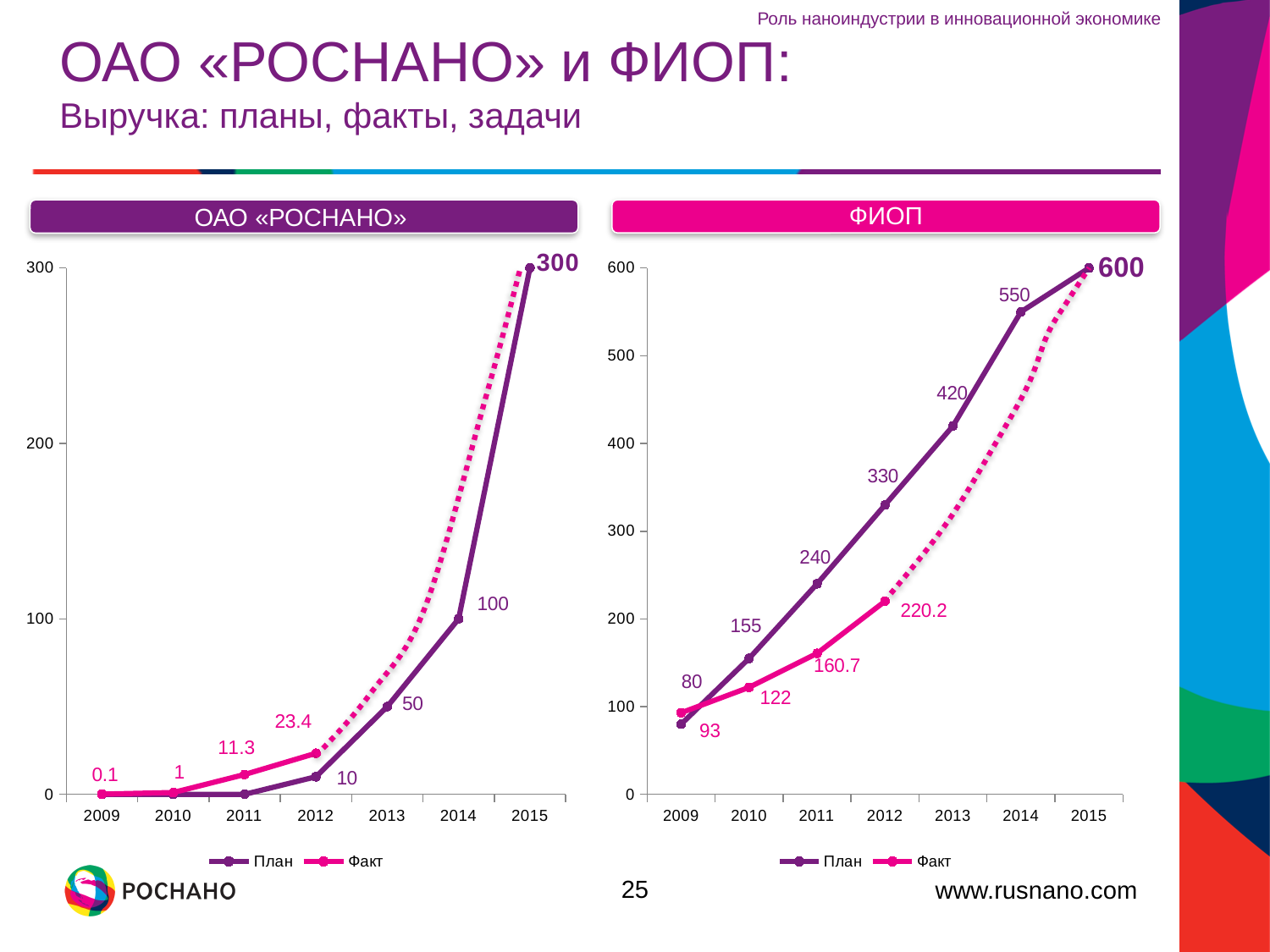
In the ФИОП chart, what is the difference between the План values for 2014 and 2013? 130 In the ОАО «РОСНАНО» chart, which year has the highest План value? 2015 In the ФИОП chart, does the План series rise or fall from 2009 to 2015? Rise In the ОАО «РОСНАНО» chart, what is the План value for 2014? 100 In the ФИОП chart, what is the Факт value for 2011? 160.7 In the ОАО «РОСНАНО» chart, what is the difference between the Факт and План values in 2012? 13.4 In the ФИОП chart, which is larger in 2012, the План value or the Факт value? План What type of chart is the ОАО «РОСНАНО» chart? Line chart In the ФИОП chart, what is the План value for 2013? 420 How many series does the legend of the ФИОП chart list? 2 In the ФИОП chart, is the План value for 2014 greater or less than 500? greater In the ОАО «РОСНАНО» chart, what is the Факт value for 2012? 23.4